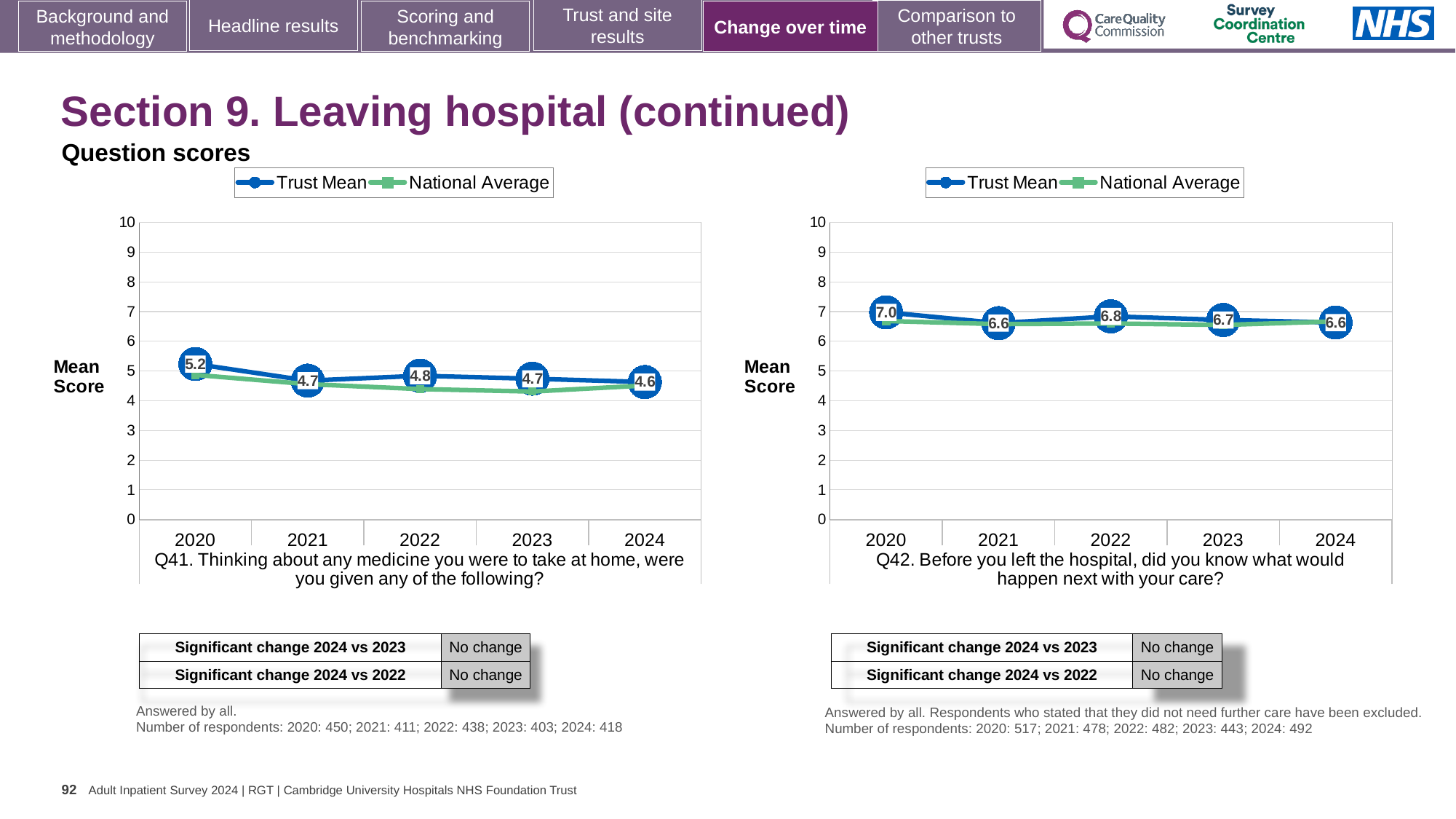
In the Q41 chart on the left, what is the difference between the Trust Mean scores for 2020 and 2024? 0.6 In the Q41 chart on the left, which year has the highest Trust Mean score? 2020 In the Q42 chart on the right, is the Trust Mean score higher in 2022 or in 2023? 2022 In the Q41 chart on the left, which year has the lowest Trust Mean score? 2024 In the Q42 chart on the right, is the National Average value for 2020 greater or less than 6? greater In the Q42 chart on the right, what is the Trust Mean score for 2022? 6.8 In the Q41 chart on the left, what is the Trust Mean score for 2020? 5.2 What type of chart is the Q41 chart on the left? Line chart In the Q42 chart on the right, what is the difference between the Trust Mean scores for 2020 and 2021? 0.4 How many series does the legend of the Q42 chart on the right list? 2 In the Q42 chart on the right, which year has the highest Trust Mean score? 2020 How many years are shown on the x axis of the Q41 chart on the left? 5